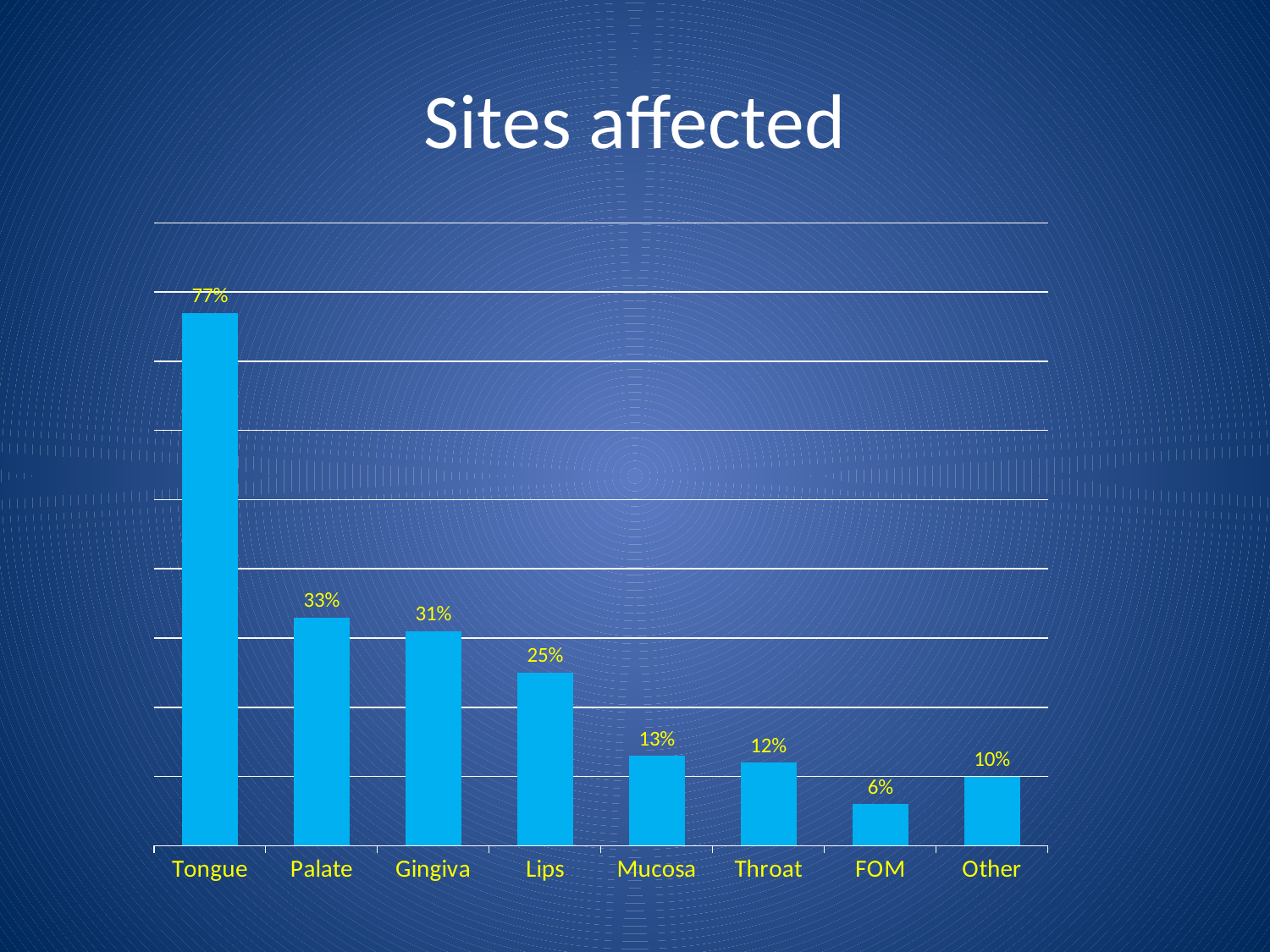
Do the values generally rise or fall from Tongue to FOM along the x axis? Fall What kind of chart is shown on the slide? Bar chart Which is larger, the value for Gingiva or the value for Lips? Gingiva What is the value for FOM? 6% What is the value for Tongue? 77% What is the title of the chart? Sites affected Which site has the lowest value? FOM How many sites are shown on the x axis? 8 What is the difference between the values for Mucosa and Throat? 1% What is the difference between the values for Tongue and Palate? 44% What is the value for Lips? 25% Which site has the highest value? Tongue